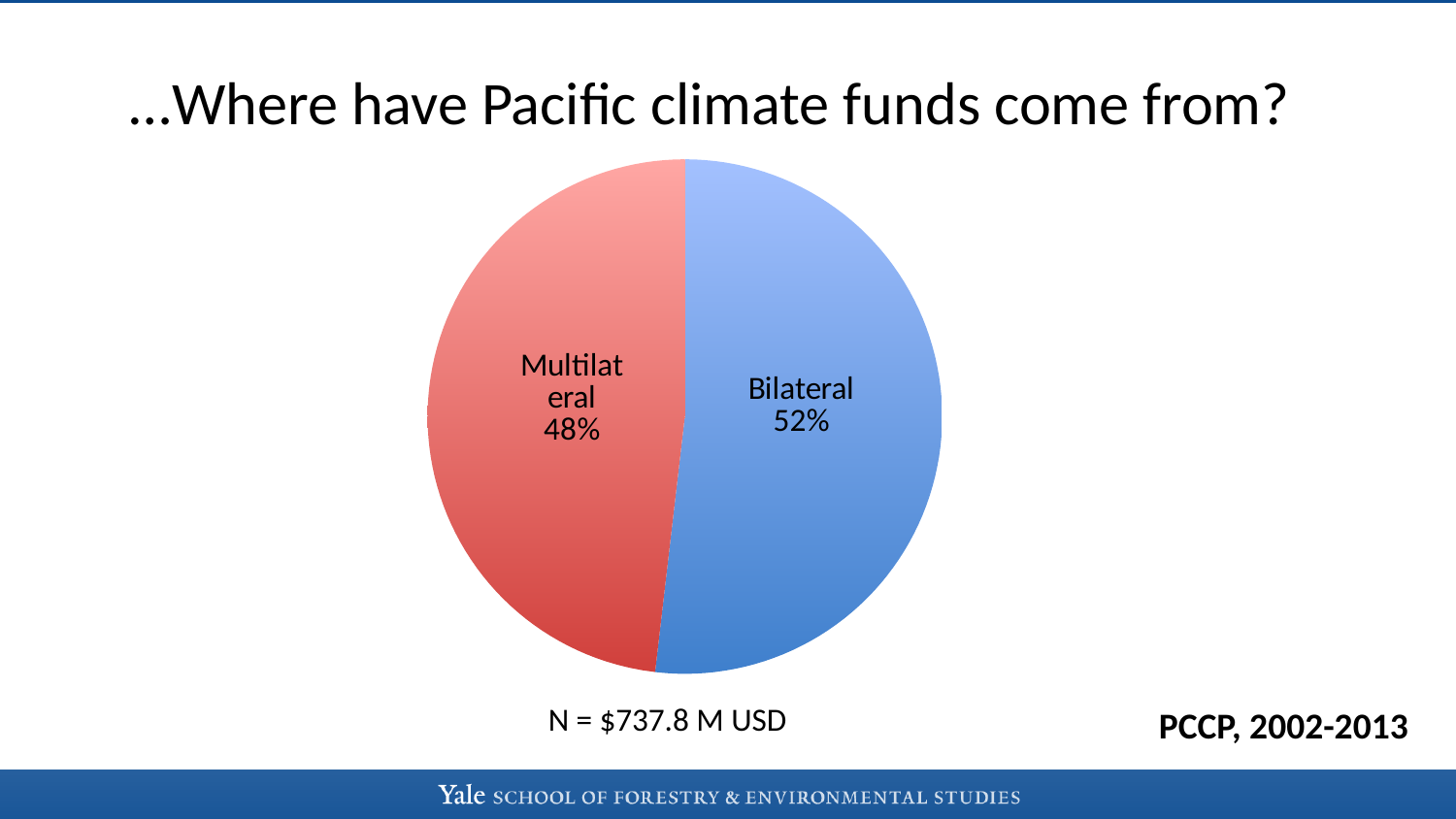
What total amount (N) is stated below the pie chart? $737.8 M USD Which slice of the pie is the smallest? Multilateral What is the difference in percentage points between the Bilateral and Multilateral shares? 4 percentage points What share of the pie does Multilateral represent? 48% What colour is the Bilateral slice of the pie? blue What share of the pie does Bilateral represent? 52% Which slice of the pie is the largest? Bilateral Which is larger, the Bilateral share or the Multilateral share? Bilateral How many slices does the pie chart have? 2 What kind of chart is shown on the slide? pie chart